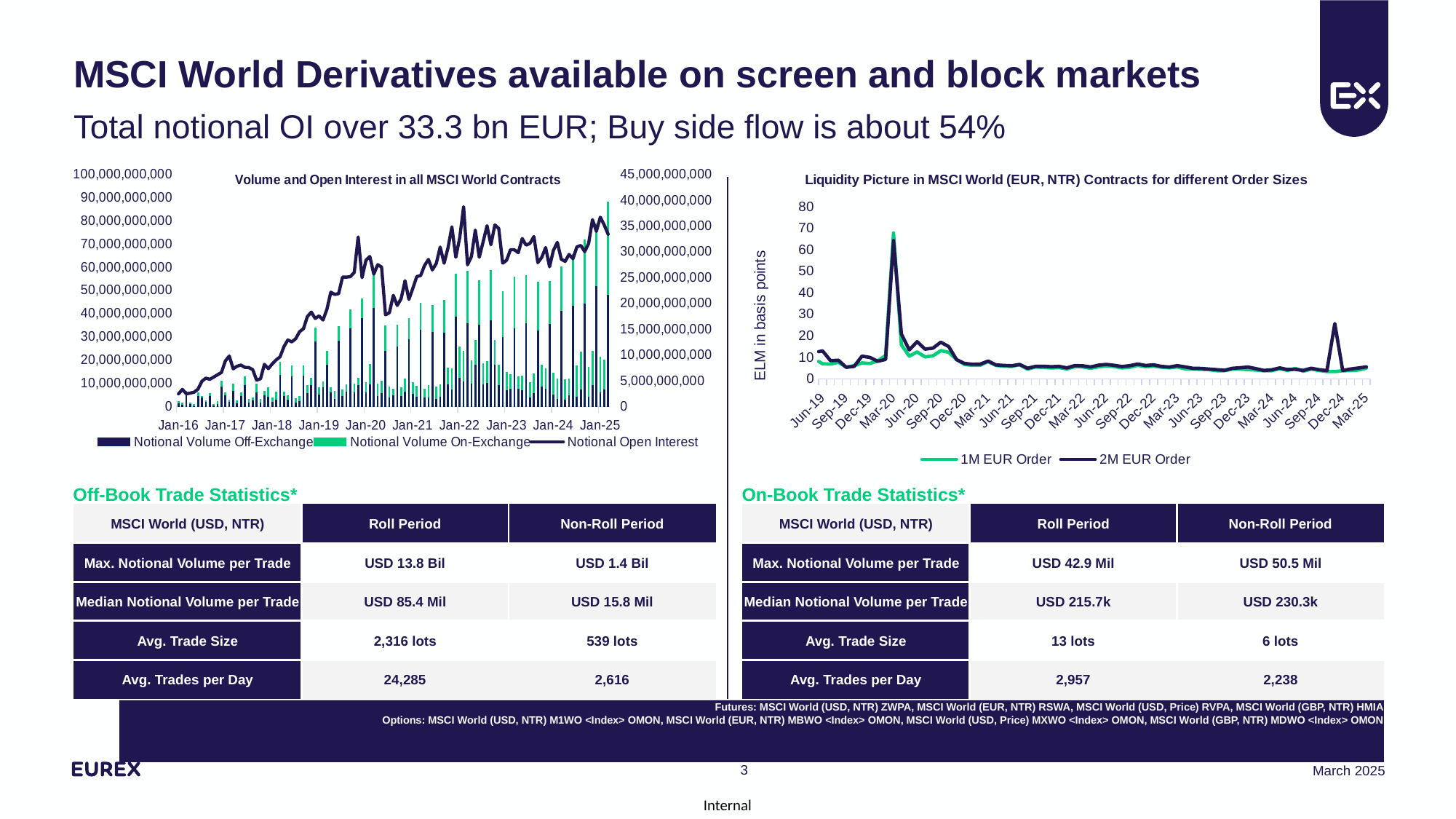
How many year labels are shown on the x-axis of the 'Volume and Open Interest in all MSCI World Contracts' chart? 10 In the 'Volume and Open Interest in all MSCI World Contracts' chart, which series is drawn as a line rather than bars? Notional Open Interest In the 'Liquidity Picture' chart, is the value of the 2M EUR Order series at the Dec-24 spike greater or less than 20? greater In the chart titled 'Volume and Open Interest in all MSCI World Contracts', how many series does the legend list? 3 What kind of chart is the 'Liquidity Picture in MSCI World (EUR, NTR) Contracts for different Order Sizes' chart? Line chart In the 'Liquidity Picture' chart, at which x-axis date does the 2M EUR Order series reach its highest value? Mar-20 In the 'Liquidity Picture' chart, is the value of the 1M EUR Order series at Mar-25 greater or less than 20? less In the chart titled 'Liquidity Picture in MSCI World (EUR, NTR) Contracts for different Order Sizes', how many series does the legend list? 2 In the 'Liquidity Picture' chart, is the peak value of the 2M EUR Order series around Mar-20 greater or less than 60? greater What is the y-axis label of the 'Liquidity Picture in MSCI World (EUR, NTR) Contracts for different Order Sizes' chart? ELM in basis points In the 'Volume and Open Interest in all MSCI World Contracts' chart, does the Notional Open Interest line generally rise or fall from Jan-16 to Jan-25? rise